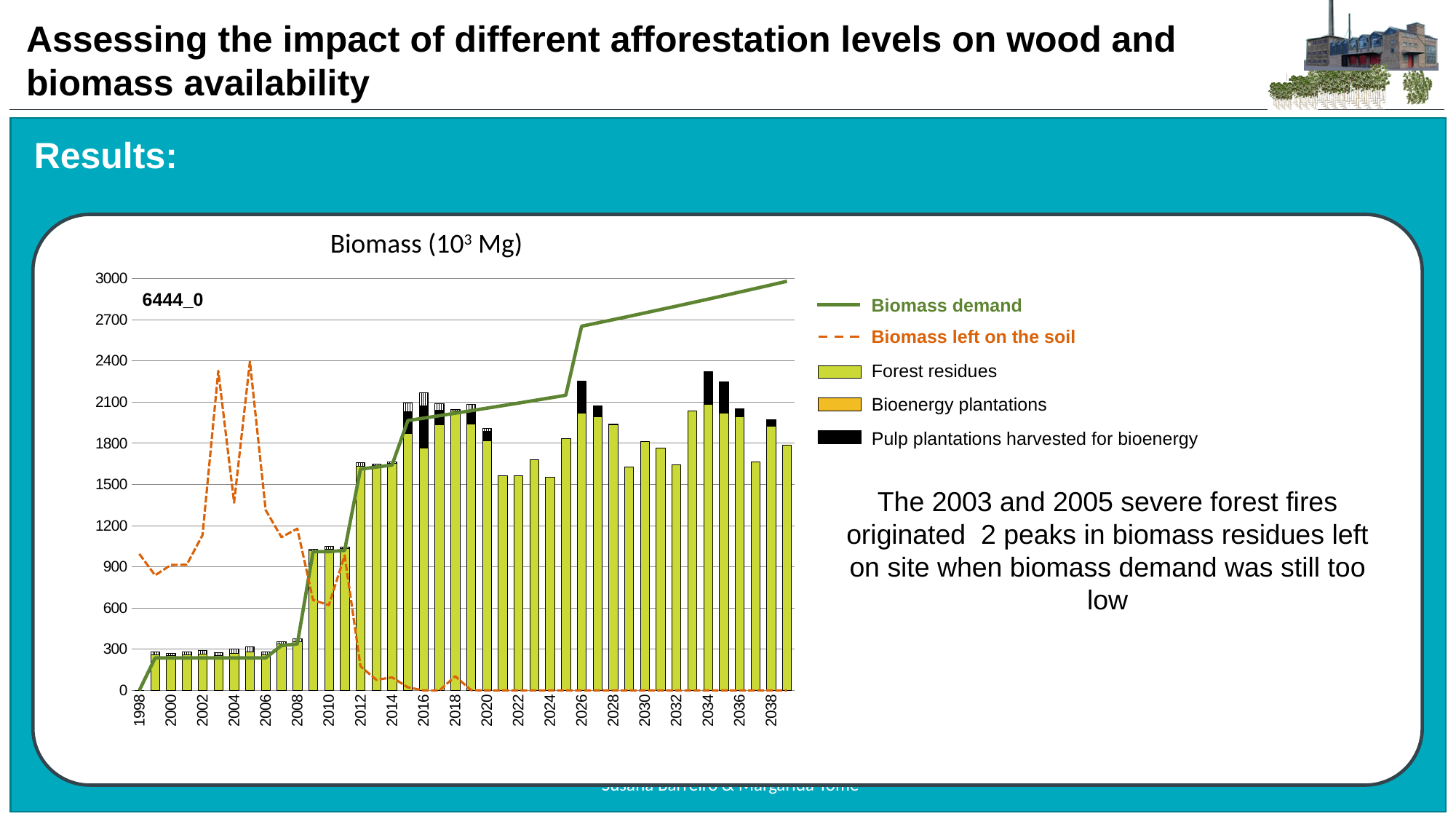
What is the title of the chart? Biomass (10³ Mg) Which is larger, Biomass demand in 2038 or Biomass demand in 2010? Biomass demand in 2038 How many series does the chart legend list? 5 Is the value of Biomass left on the soil in 2005 greater or less than 2100? greater Is the Forest residues bar for 2000 greater or less than 300? less Is the value of Biomass demand in 2038 greater or less than 2700? greater What kind of chart is used to show Forest residues, Bioenergy plantations and Pulp plantations harvested for bioenergy? bar chart Which series is drawn as a dashed orange line? Biomass left on the soil In which year does Biomass left on the soil reach its highest value? 2005 Does the Biomass demand line rise or fall from 1998 to 2038? rise